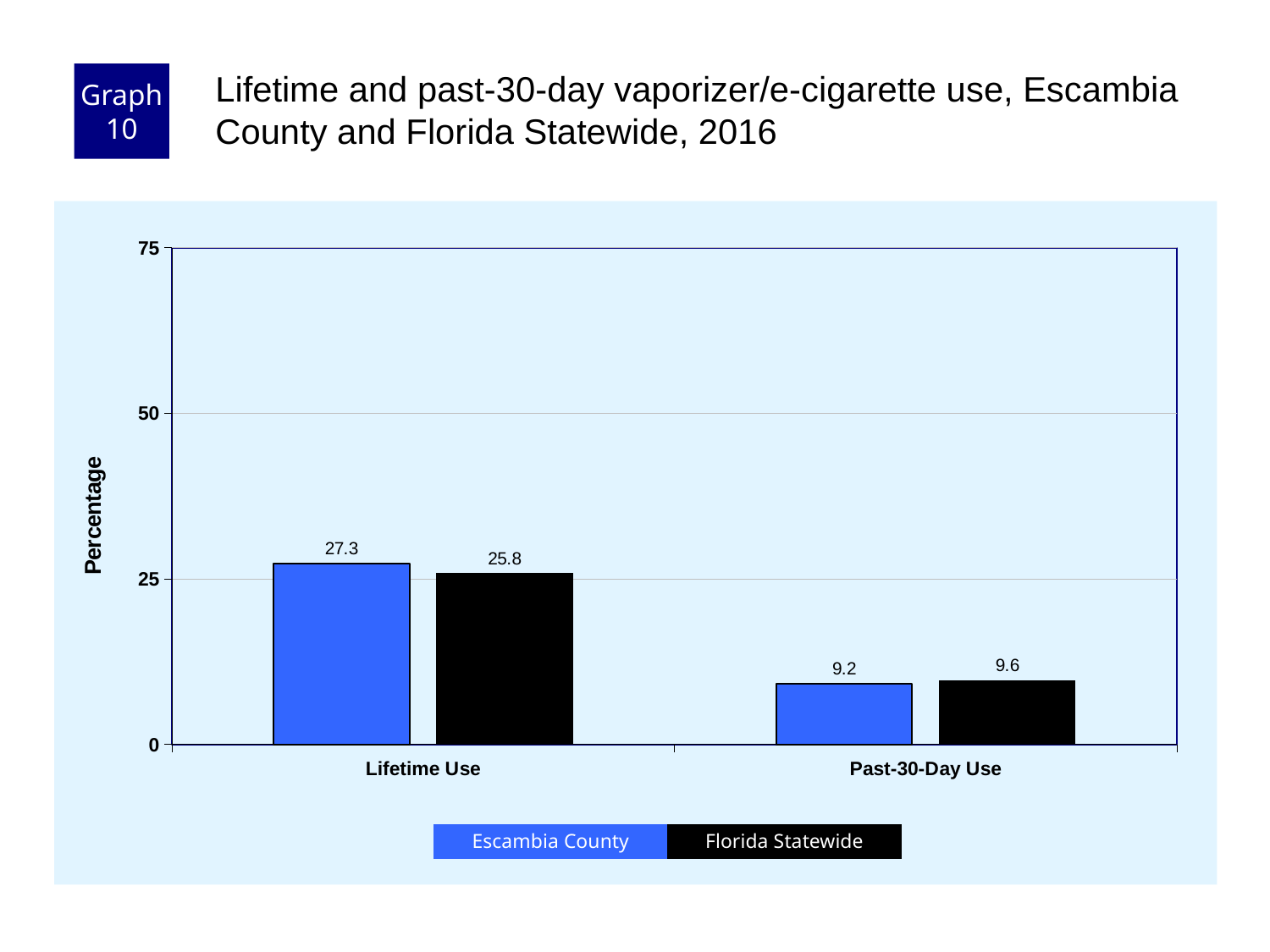
What is the difference between the Escambia County and Florida Statewide values for Lifetime Use? 1.5 Which category has the highest Escambia County value? Lifetime Use Is the Escambia County value for Lifetime Use greater or less than 25? greater How many categories are shown on the x axis? 2 What kind of chart is shown on the slide? bar chart For Past-30-Day Use, which is larger: Escambia County or Florida Statewide? Florida Statewide What is the Escambia County value for Lifetime Use? 27.3 What is the Florida Statewide value for Past-30-Day Use? 9.6 Which category has the lowest Florida Statewide value? Past-30-Day Use What is the Escambia County value for Past-30-Day Use? 9.2 How many series does the legend list? 2 What is the Florida Statewide value for Lifetime Use? 25.8